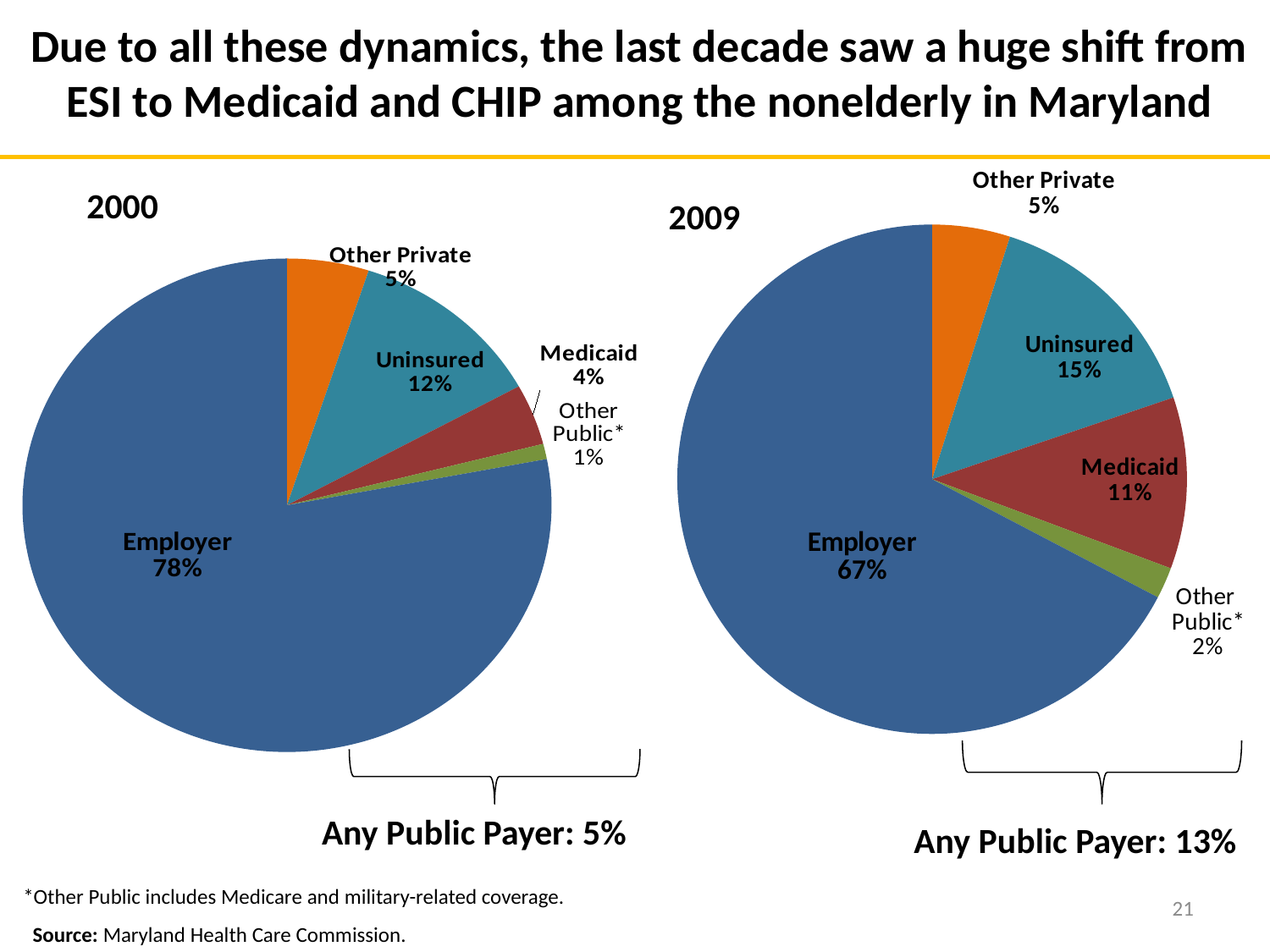
In the 2009 pie chart, which category has the smallest slice? Other Public What type of chart is used for the 2000 data? Pie chart What is the difference between the Employer share in the 2000 pie chart and the Employer share in the 2009 pie chart? 11% In the 2009 pie chart, what share does Medicaid have? 11% In the 2000 pie chart, what share does Other Public have? 1% In the 2009 pie chart, what is the difference between the Uninsured share and the Medicaid share? 4% In the 2000 pie chart, which category has the largest slice? Employer Which is larger: the Medicaid share in the 2000 pie chart or the Medicaid share in the 2009 pie chart? 2009 How many slices does the 2009 pie chart have? 5 In the 2009 pie chart, what share does Uninsured have? 15% What is the Any Public Payer share shown under the 2009 pie chart? 13% In the 2000 pie chart, what share does Employer have? 78%